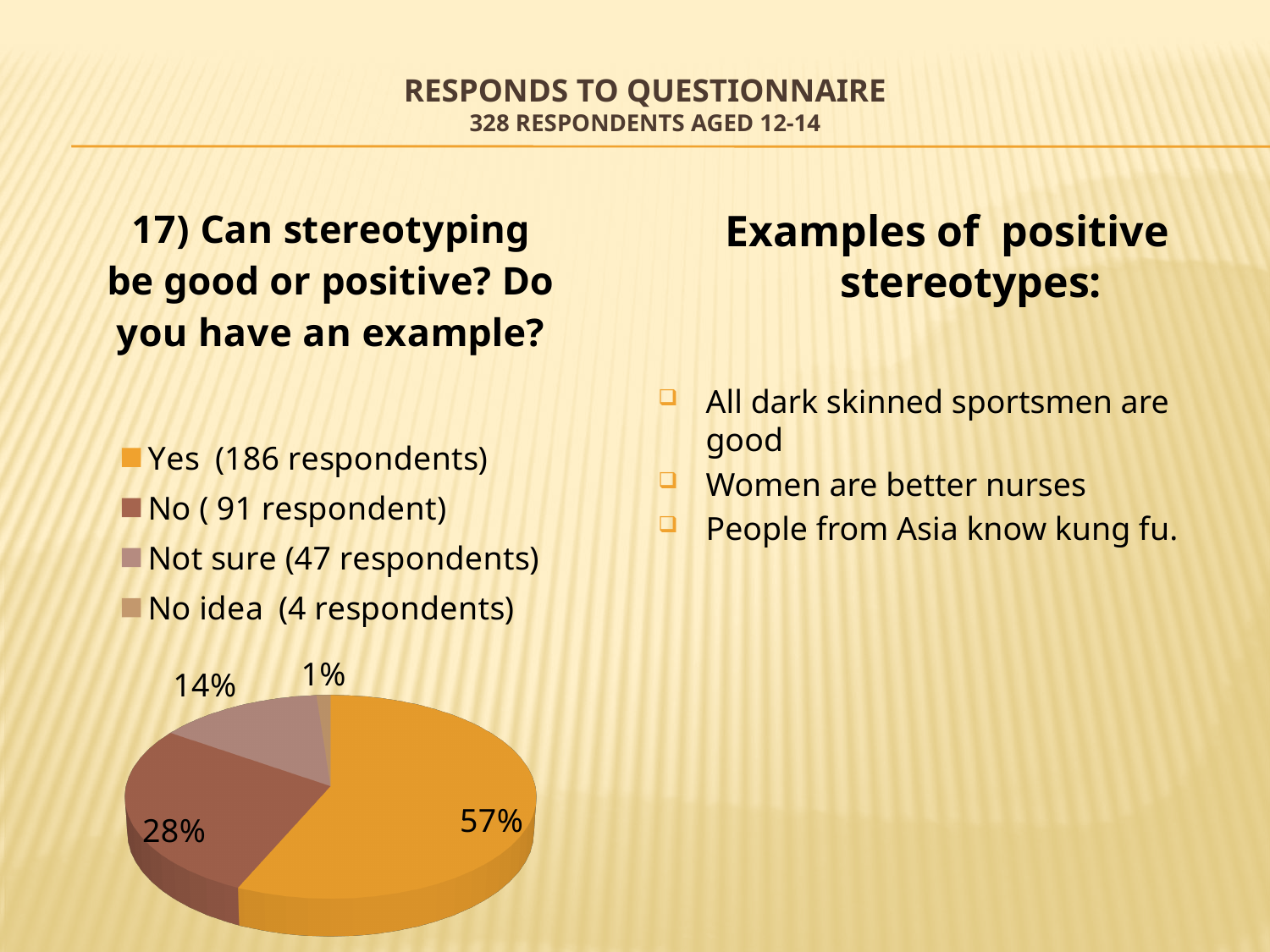
Which category has the largest slice of the pie? Yes What percentage of the pie does the "Not sure" slice represent? 14% Which category has the smallest slice of the pie? No idea What is the difference in percentage points between the "Yes" slice and the "No" slice? 29 What kind of chart is shown on the slide? pie chart What percentage of the pie does the "No idea" slice represent? 1% According to the legend, how many respondents answered "Not sure"? 47 respondents Which slice is larger, "No" or "Not sure"? No How many categories does the pie chart show? 4 What is the question the pie chart is about, as given in its title? 17) Can stereotyping be good or positive? Do you have an example? What percentage of the pie does the "No" slice represent? 28%